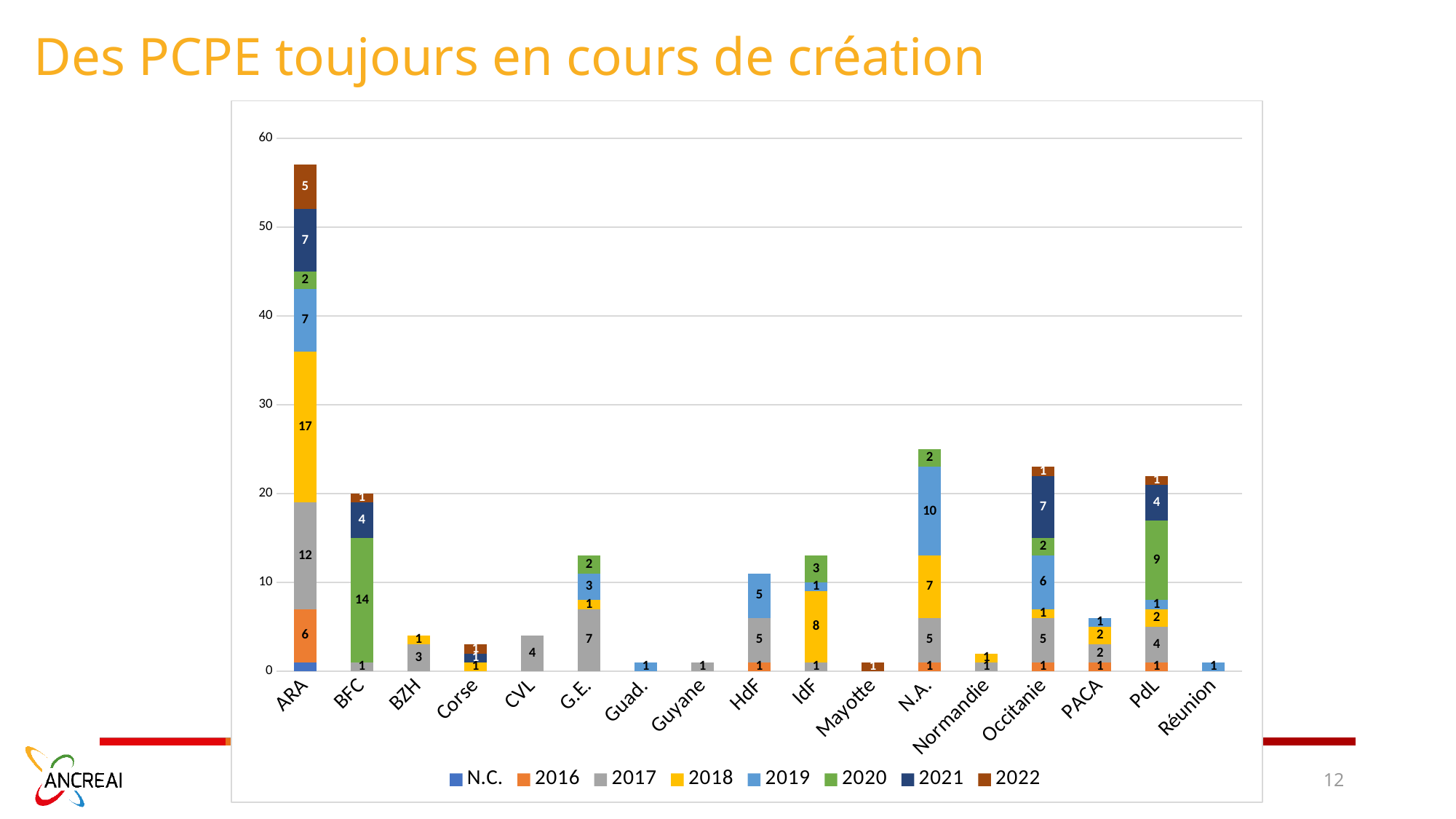
What is the 2020 value for BFC? 14 What is the difference between the 2018 value for ARA and the 2018 value for IdF? 9 How many series does the legend list? 8 What is the total of the stacked bar for N.A.? 25 Which is larger: the 2021 value for Occitanie or the 2021 value for PdL? Occitanie How many regions (categories) are shown on the x axis? 17 Is the total stacked bar for Occitanie greater or less than 20? greater What is the total of the stacked bar for ARA? 57 Which region has the tallest stacked bar? ARA What is the 2018 value for ARA? 17 What kind of chart is shown on the slide? Stacked bar chart What is the 2019 value for N.A.? 10